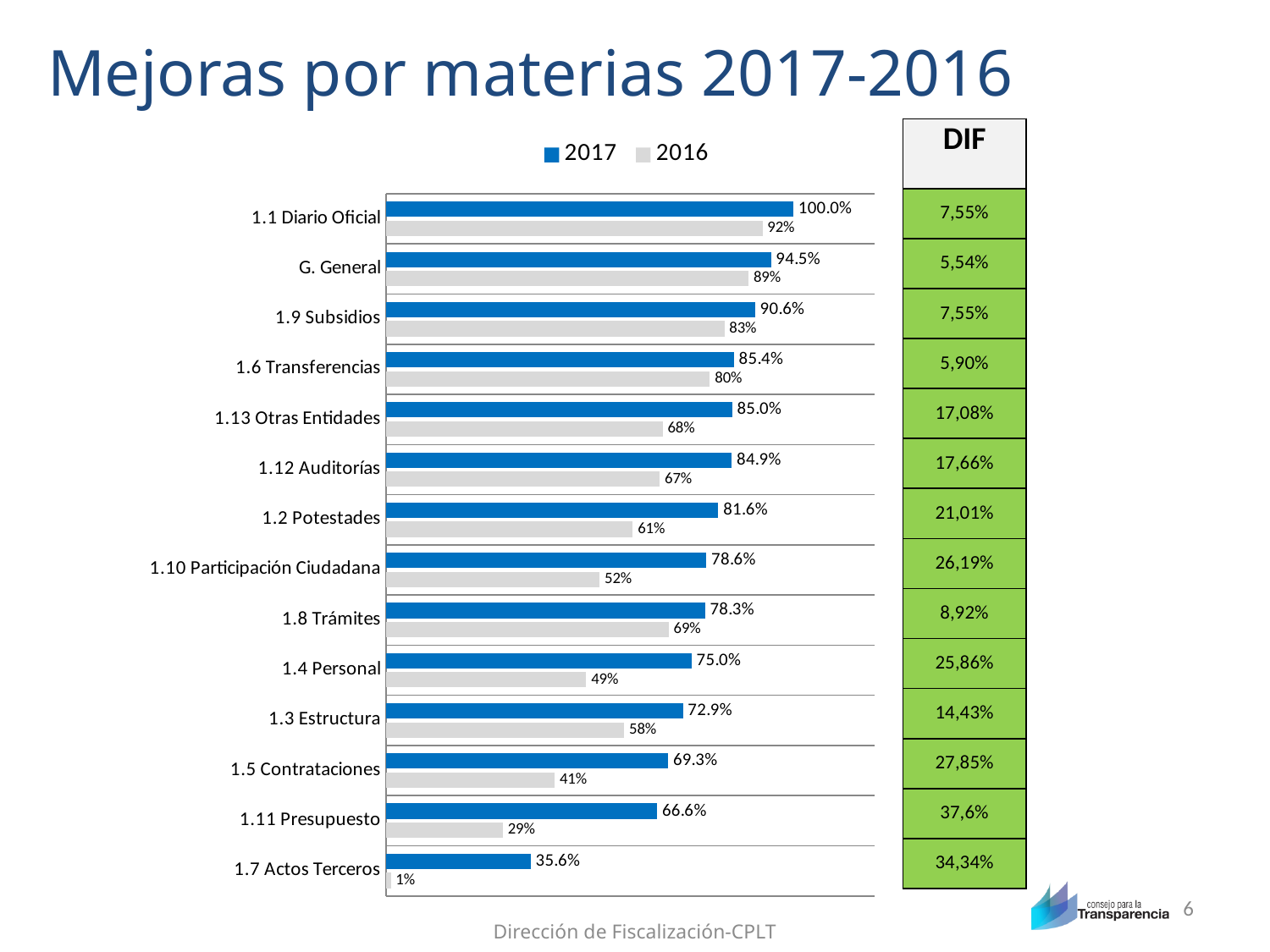
How many series does the legend list? 2 How many categories are shown in the chart? 14 What is the 2017 value for 1.5 Contrataciones? 69.3% Which has the larger 2016 value, 1.4 Personal or 1.3 Estructura? 1.3 Estructura What is the 2017 value for 1.9 Subsidios? 90.6% Which category has the lowest 2016 value? 1.7 Actos Terceros What are the two series listed in the legend? 2017 and 2016 What is the 2016 value for 1.10 Participación Ciudadana? 52% Which category has the highest 2017 value? 1.1 Diario Oficial What is the title of the slide? Mejoras por materias 2017-2016 What kind of chart is shown on the slide? Bar chart What is the difference between the 2017 and 2016 values for 1.11 Presupuesto? 37.6 percentage points